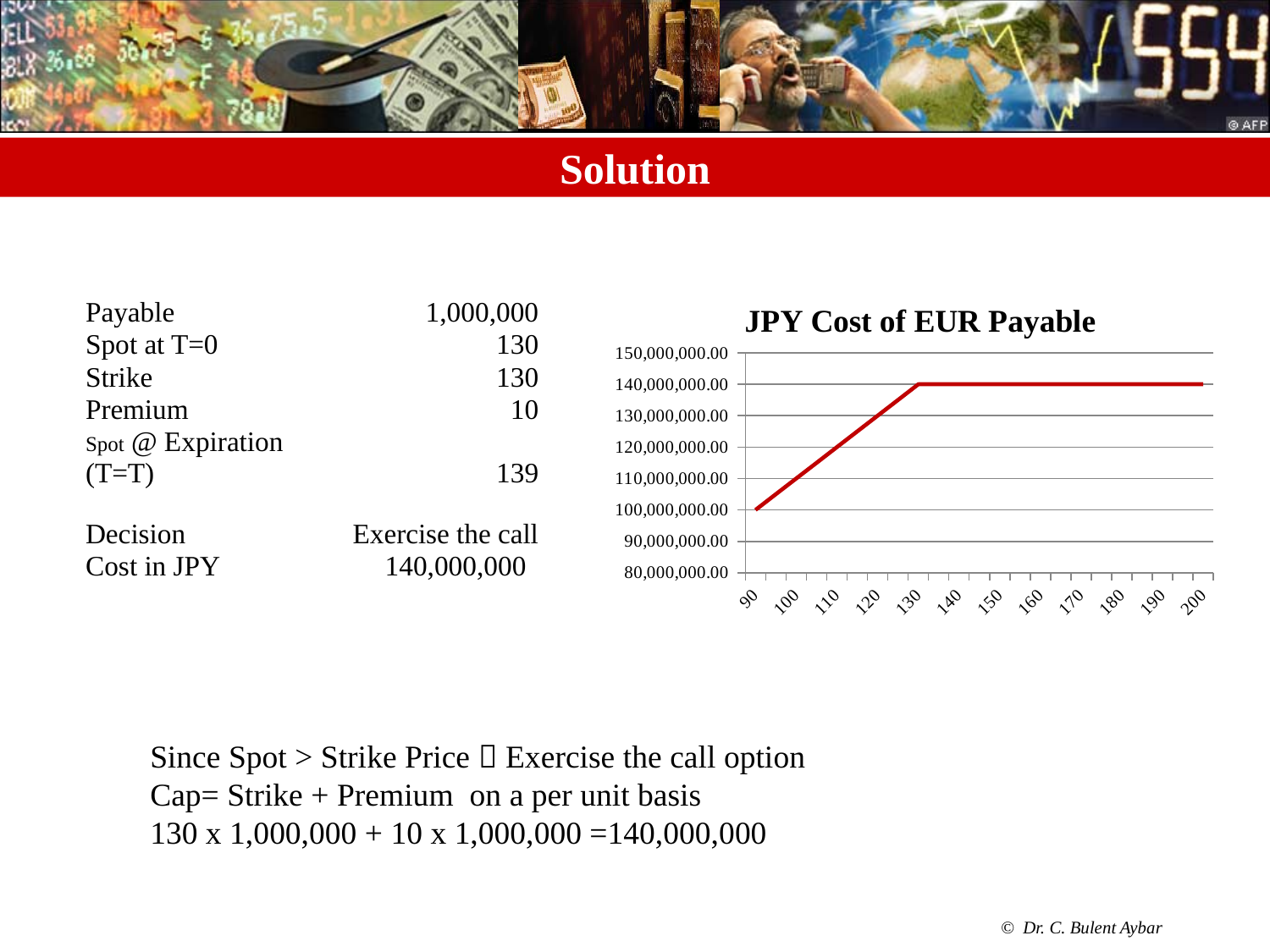
What is the highest JPY cost reached by the line? 140,000,000.00 What is the difference between the JPY cost at spot 130 and at spot 90? 40,000,000.00 What is the title of the chart? JPY Cost of EUR Payable What kind of chart is shown on the slide? line chart Which has the larger JPY cost, spot 100 or spot 150? 150 What is the JPY cost when the spot rate is 200? 140,000,000.00 How many x-axis tick labels does the chart show? 12 How does the JPY cost change as the spot rate moves from 90 to 130? it rises What is the JPY cost when the spot rate is 90? 100,000,000.00 What is the JPY cost when the spot rate is 130? 140,000,000.00 Is the JPY cost at spot 110 greater or less than 130,000,000.00? less At which spot rate on the x axis is the JPY cost lowest? 90